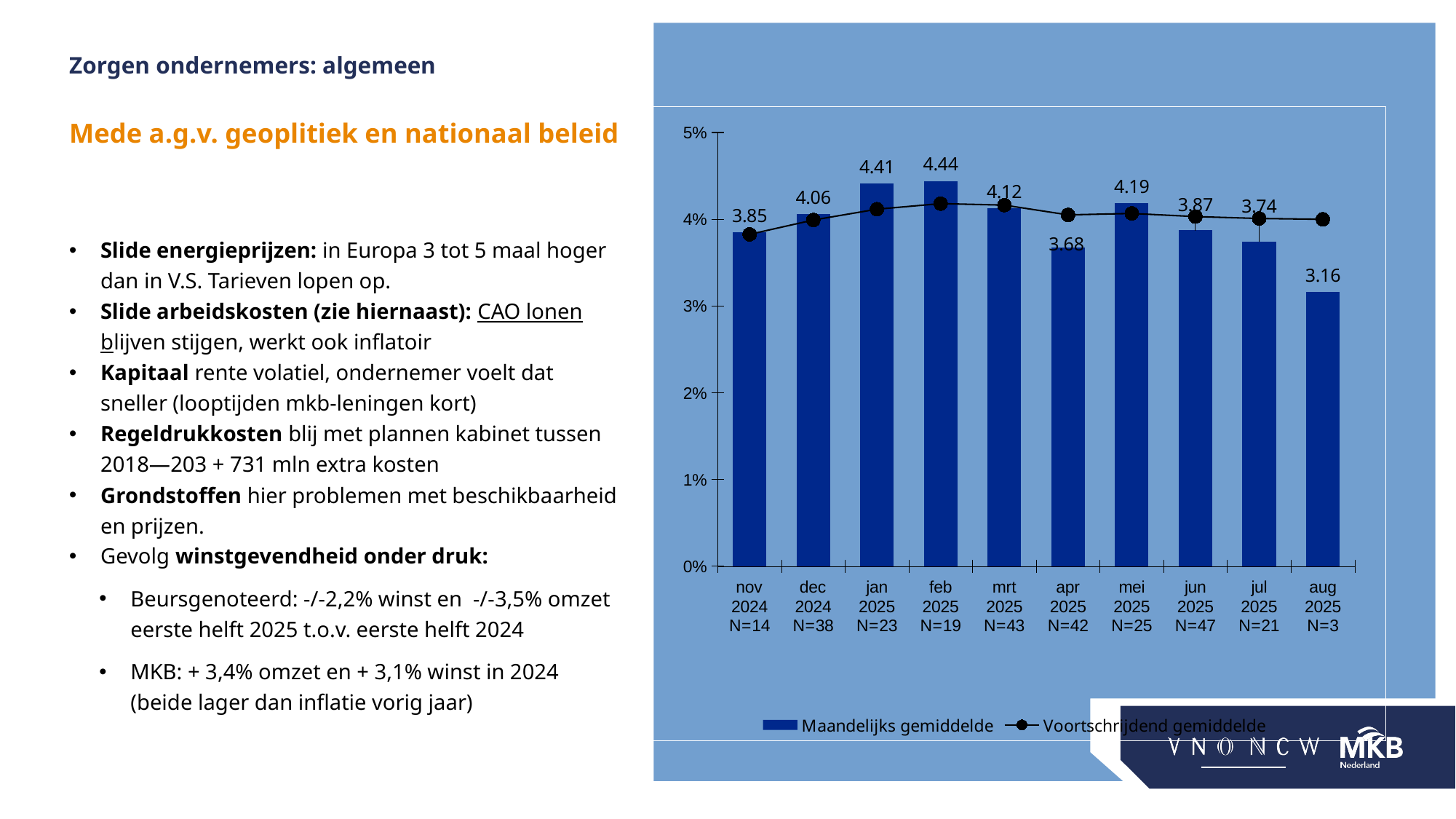
What kind of chart is shown on the slide? Bar chart with a line How many months are shown on the x axis of the chart? 10 Which is larger, the Maandelijks gemiddelde bar for mei 2025 or for jun 2025? mei 2025 What is the value of the Maandelijks gemiddelde bar for aug 2025? 3.16 What is the value of the Maandelijks gemiddelde bar for feb 2025? 4.44 What is the sample size (N) shown for aug 2025 on the x axis? N=3 Is the Voortschrijdend gemiddelde value for aug 2025 greater or less than 3%? greater What is the difference between the Maandelijks gemiddelde values for jan 2025 and apr 2025? 0.73 What is the value of the Maandelijks gemiddelde bar for nov 2024? 3.85 Which month has the lowest Maandelijks gemiddelde bar? aug 2025 How many series does the chart legend list? 2 Which month has the highest Maandelijks gemiddelde bar? feb 2025